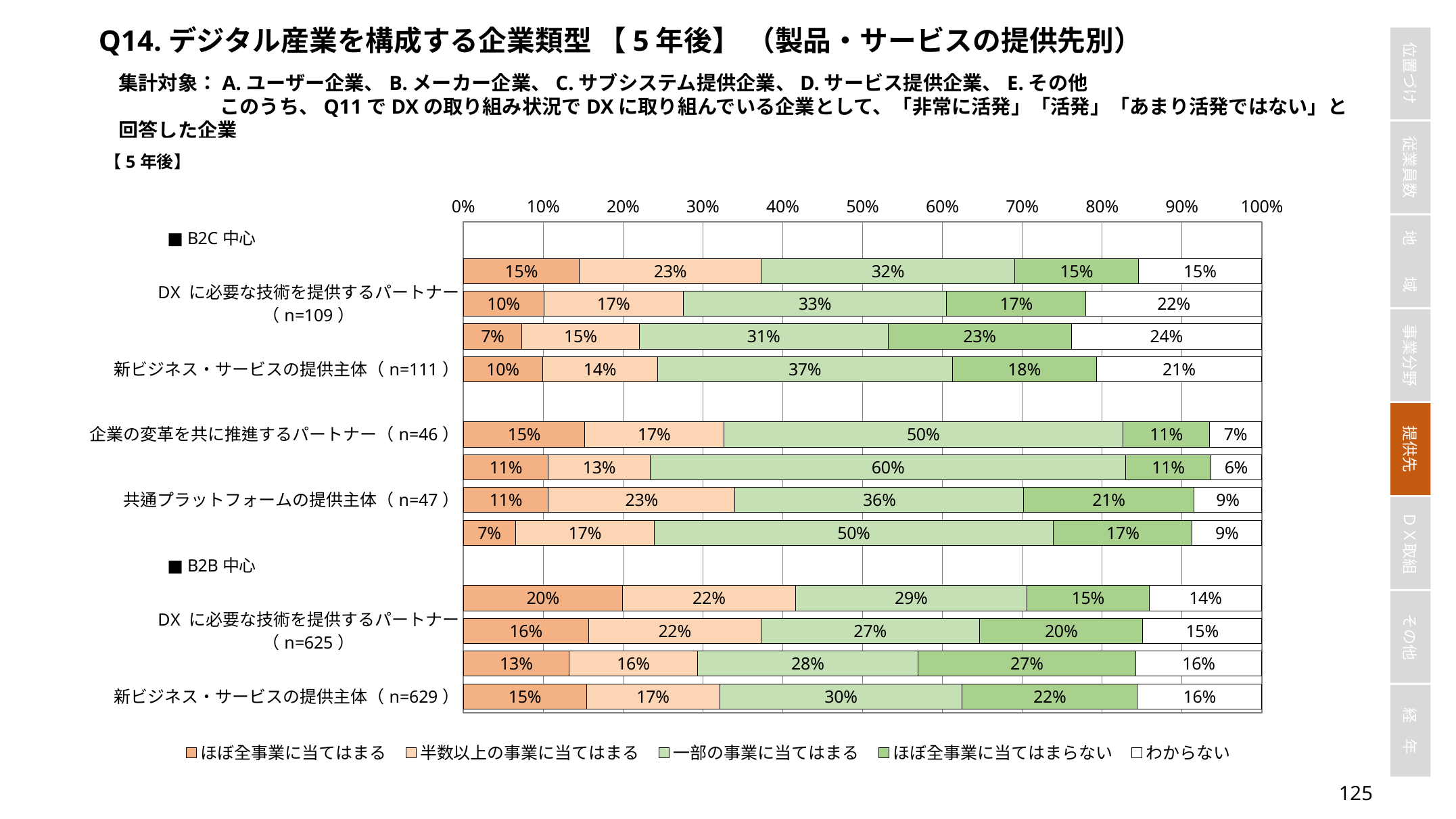
What is the value of 一部の事業に当てはまる for 企業の変革を共に推進するパートナー（n=46）? 50% Which segment is the largest in the bar for 企業の変革を共に推進するパートナー（n=46）? 一部の事業に当てはまる How many bars are plotted in the chart? 12 What is the value of 一部の事業に当てはまる for 新ビジネス・サービスの提供主体（n=111）in the B2C 中心 group? 37% How many series does the legend list? 5 Which segment is the smallest in the bar for 共通プラットフォームの提供主体（n=47）? わからない What is the value of わからない for 新ビジネス・サービスの提供主体（n=111）in the B2C 中心 group? 21% What kind of chart is shown on the slide? bar chart What is the value of ほぼ全事業に当てはまらない for 共通プラットフォームの提供主体（n=47）? 21% What is the value of わからない for 新ビジネス・サービスの提供主体（n=629）in the B2B 中心 group? 16% Which has the larger ほぼ全事業に当てはまる value: 新ビジネス・サービスの提供主体（n=629）or 共通プラットフォームの提供主体（n=47）? 新ビジネス・サービスの提供主体（n=629） What is the difference between the 一部の事業に当てはまる value for 企業の変革を共に推進するパートナー（n=46）and that for 新ビジネス・サービスの提供主体（n=111）? 13 percentage points